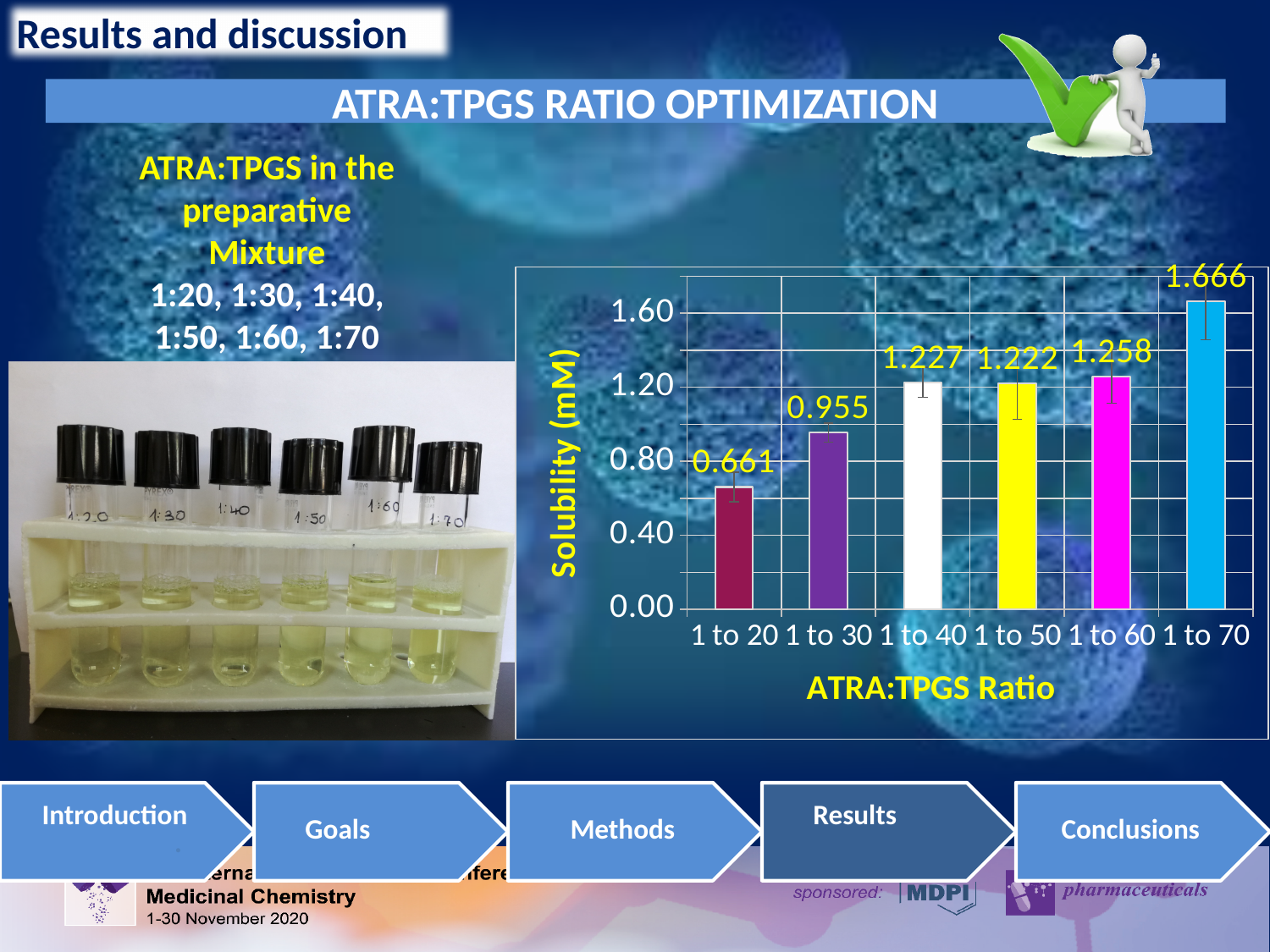
What is the difference in solubility between the 1 to 30 and 1 to 20 ratios? 0.294 What is the solubility value for the 1 to 70 ratio? 1.666 Which ATRA:TPGS ratio has the highest solubility? 1 to 70 How many ATRA:TPGS ratios are plotted in the chart? 6 Which ATRA:TPGS ratio has the lowest solubility? 1 to 20 What is the solubility value for the 1 to 30 ratio? 0.955 What is the label of the y axis of the chart? Solubility (mM) What is the solubility value for the 1 to 60 ratio? 1.258 What kind of chart is used to show solubility versus ATRA:TPGS ratio? Bar chart What is the difference in solubility between the 1 to 70 and 1 to 20 ratios? 1.005 Which has a higher solubility, the 1 to 30 ratio or the 1 to 60 ratio? 1 to 60 What is the solubility value for the 1 to 20 ATRA:TPGS ratio? 0.661